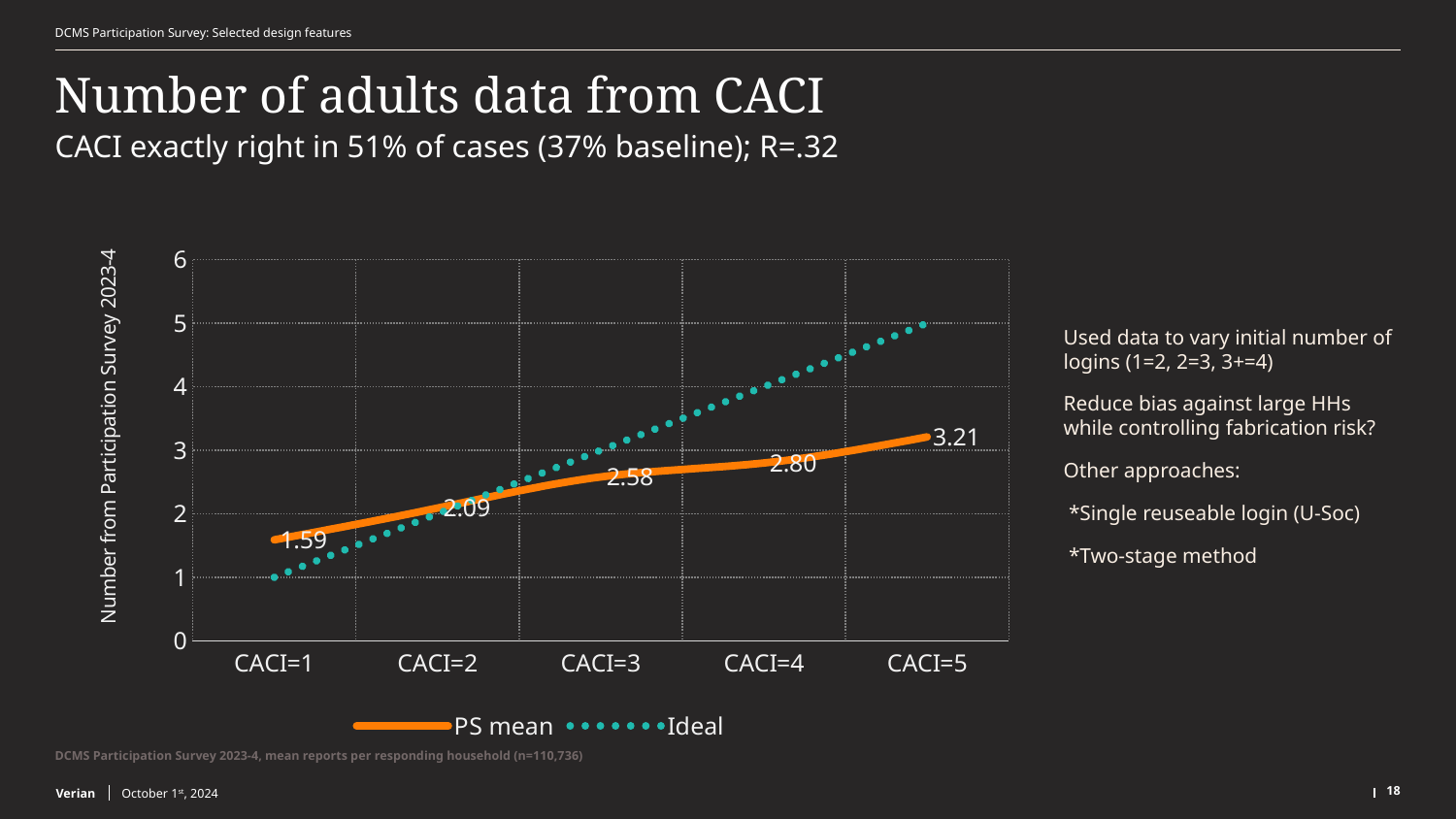
At CACI=4, which series is higher, PS mean or Ideal? Ideal Is the PS mean for CACI=2 greater or less than 2? greater What is the PS mean value for CACI=3? 2.58 Which CACI category has the highest PS mean? CACI=5 What is the PS mean value for CACI=1? 1.59 How many CACI categories are shown on the x axis? 5 What is the difference between the PS mean for CACI=5 and CACI=1? 1.62 Which CACI category has the lowest PS mean? CACI=1 What is the PS mean value for CACI=4? 2.80 What is the PS mean value for CACI=5? 3.21 How many series does the legend list? 2 Does the PS mean rise or fall from CACI=1 to CACI=5? rise